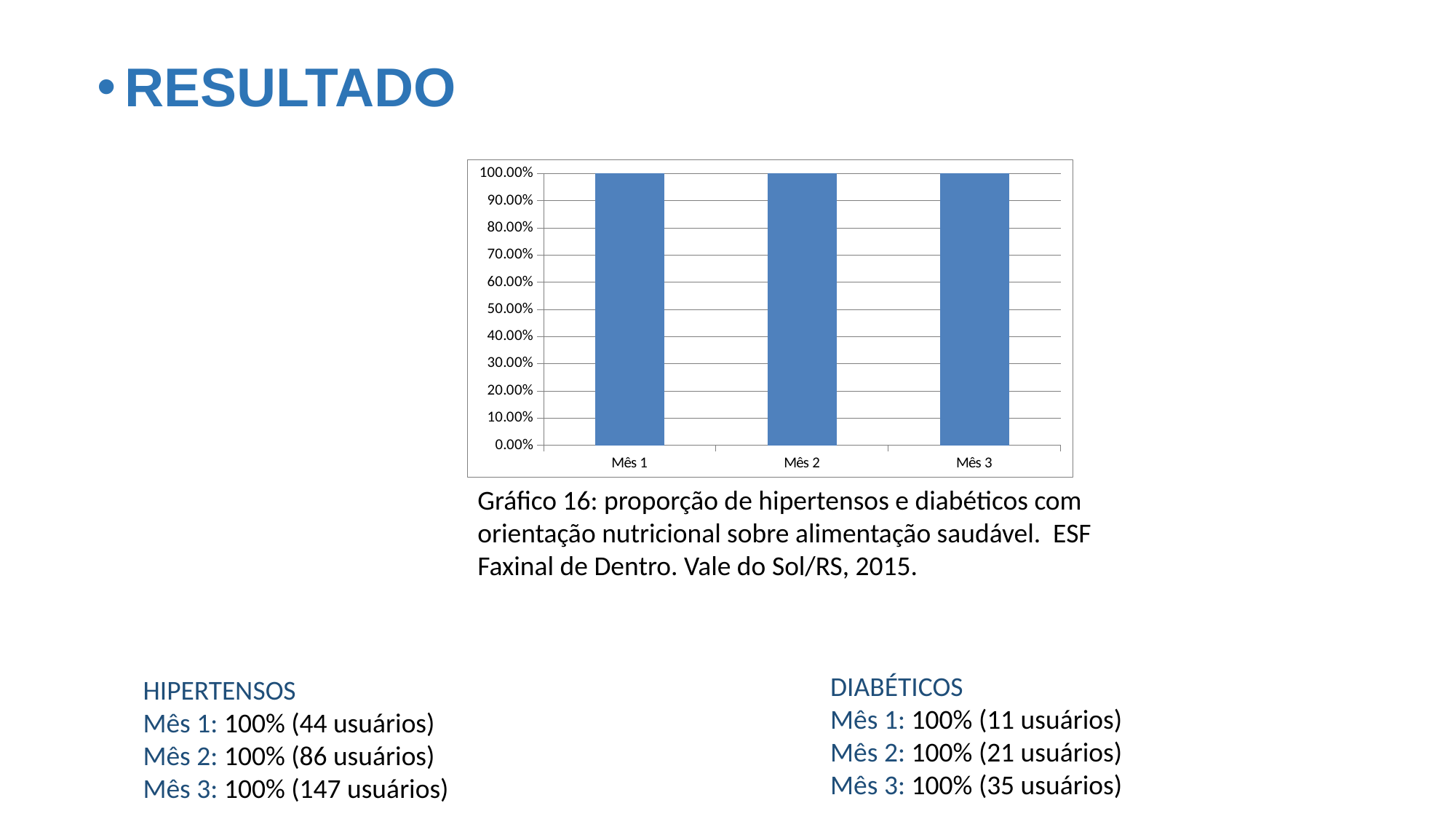
What is the difference between the values for Mês 1 and Mês 3? 0.00% How many categories are plotted on the x axis of the chart? 3 What is the value for Mês 2 in the chart? 100.00% What kind of chart is shown on the slide? bar chart Is the value for Mês 3 greater or less than 90.00%? greater What is the label of the first category on the x axis? Mês 1 Do the values rise, fall or stay the same from Mês 1 to Mês 3? stay the same Is the value for Mês 2 greater or less than 50.00%? greater What is the value for Mês 3 in the chart? 100.00% What is the value for Mês 1 in the chart? 100.00% What colour are the bars in the chart? blue